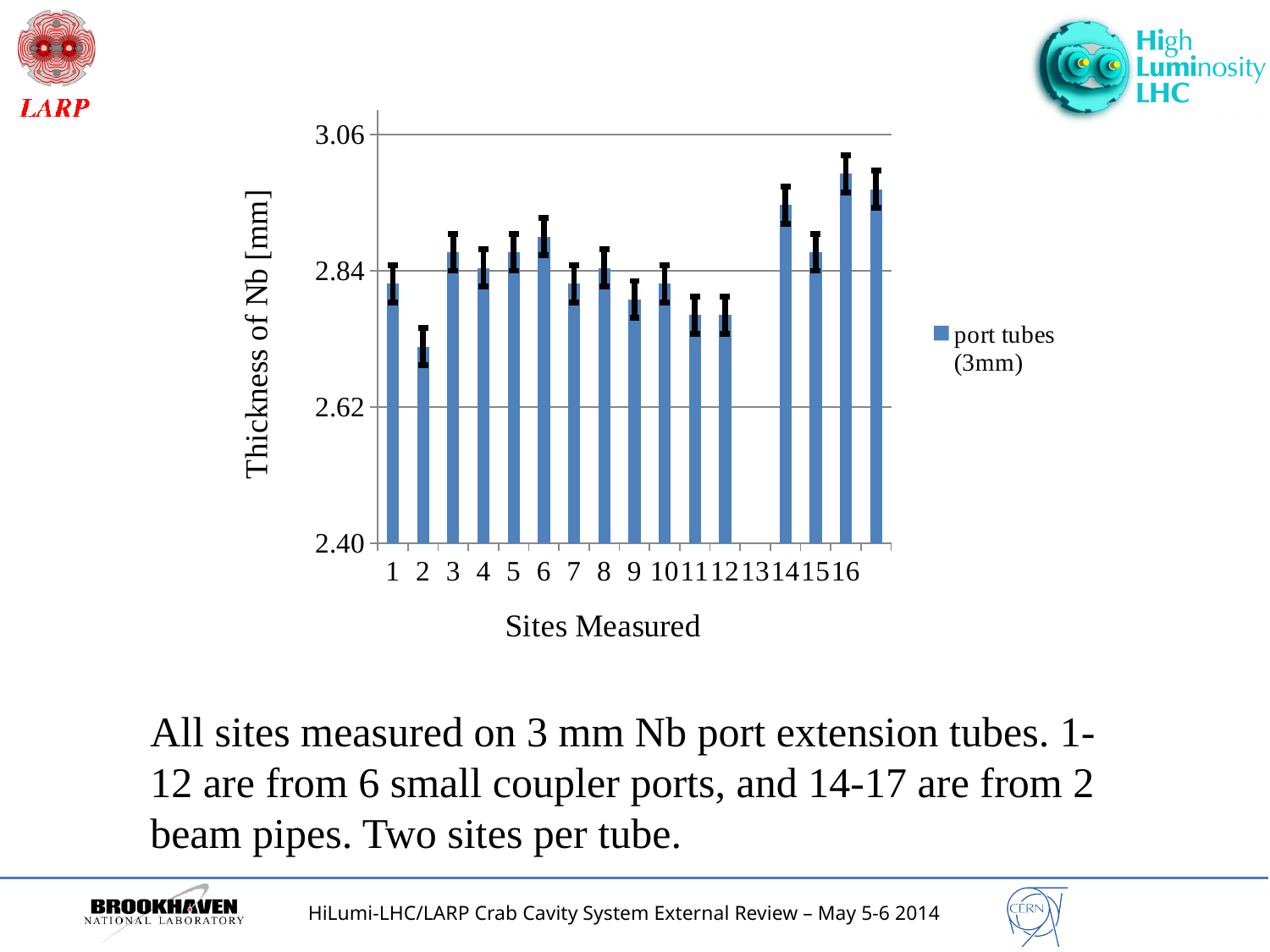
Which has the larger thickness of Nb, site 2 or site 16? site 16 Is the value for site 2 greater or less than 2.84? less Which site has the lowest thickness of Nb? 2 Is the value for site 14 greater or less than 2.84? greater Which has the larger thickness of Nb, site 11 or site 14? site 14 What is the title of the y axis of the chart? Thickness of Nb [mm] How many series does the legend list? 1 What kind of chart is shown on the slide? bar chart Is the value for site 11 greater or less than 2.84? less What is the legend entry for the series in the chart? port tubes (3mm) Which site has the highest thickness of Nb? 16